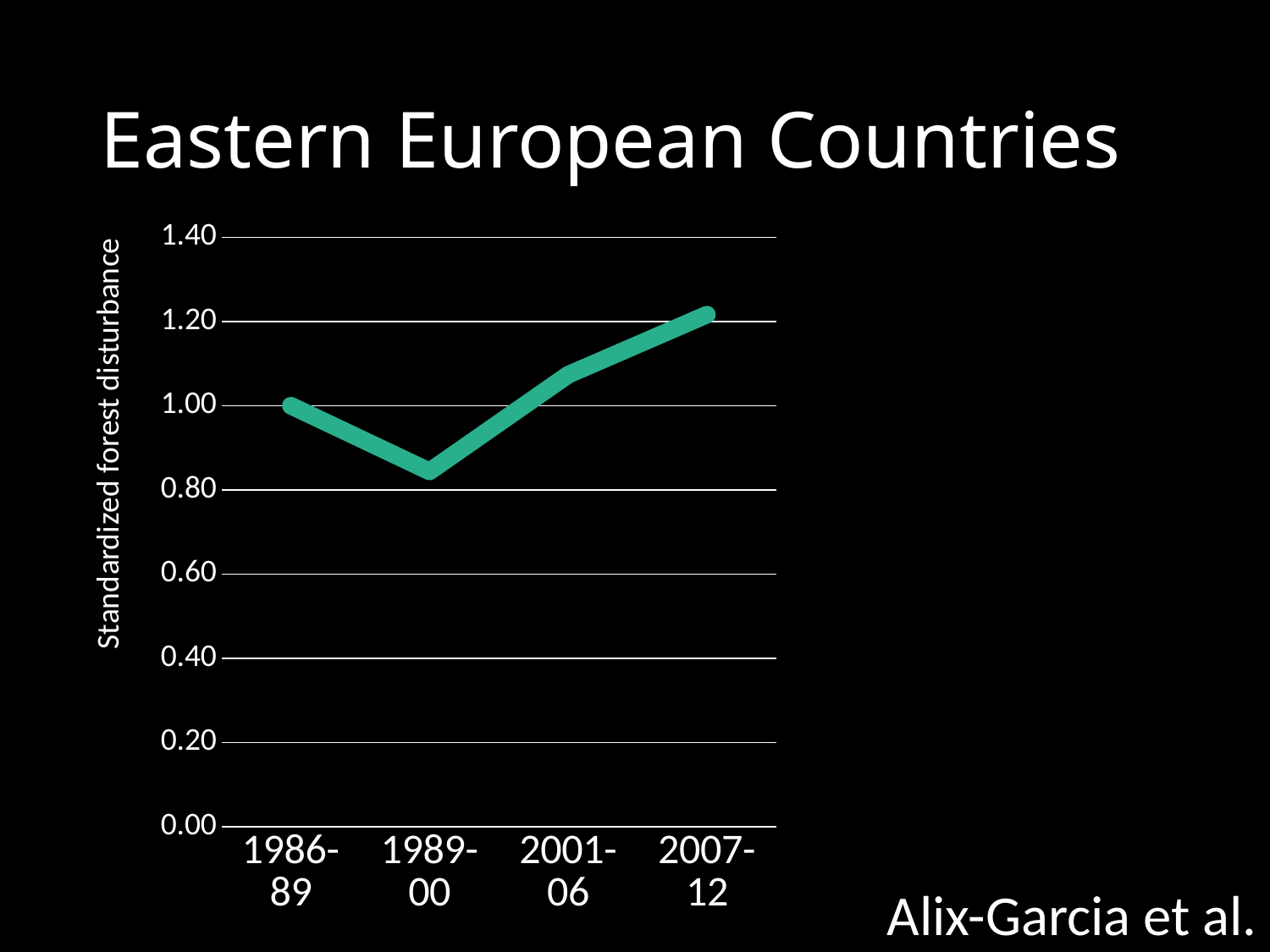
Which period has the lowest standardized forest disturbance? 1989-00 Is the value for 2007-12 greater or less than 1.00? greater Do the values rise or fall from 1989-00 to 2007-12? rise Is the value for 1989-00 greater or less than 1.00? less How many time periods are plotted on the x axis? 4 Which is larger, the value for 1986-89 or the value for 2007-12? 2007-12 What is the label on the y axis? Standardized forest disturbance Is the value for 2001-06 greater or less than 1.00? greater Which period has the highest standardized forest disturbance? 2007-12 What kind of chart is shown on the slide? line chart Which is larger, the value for 1989-00 or the value for 2001-06? 2001-06